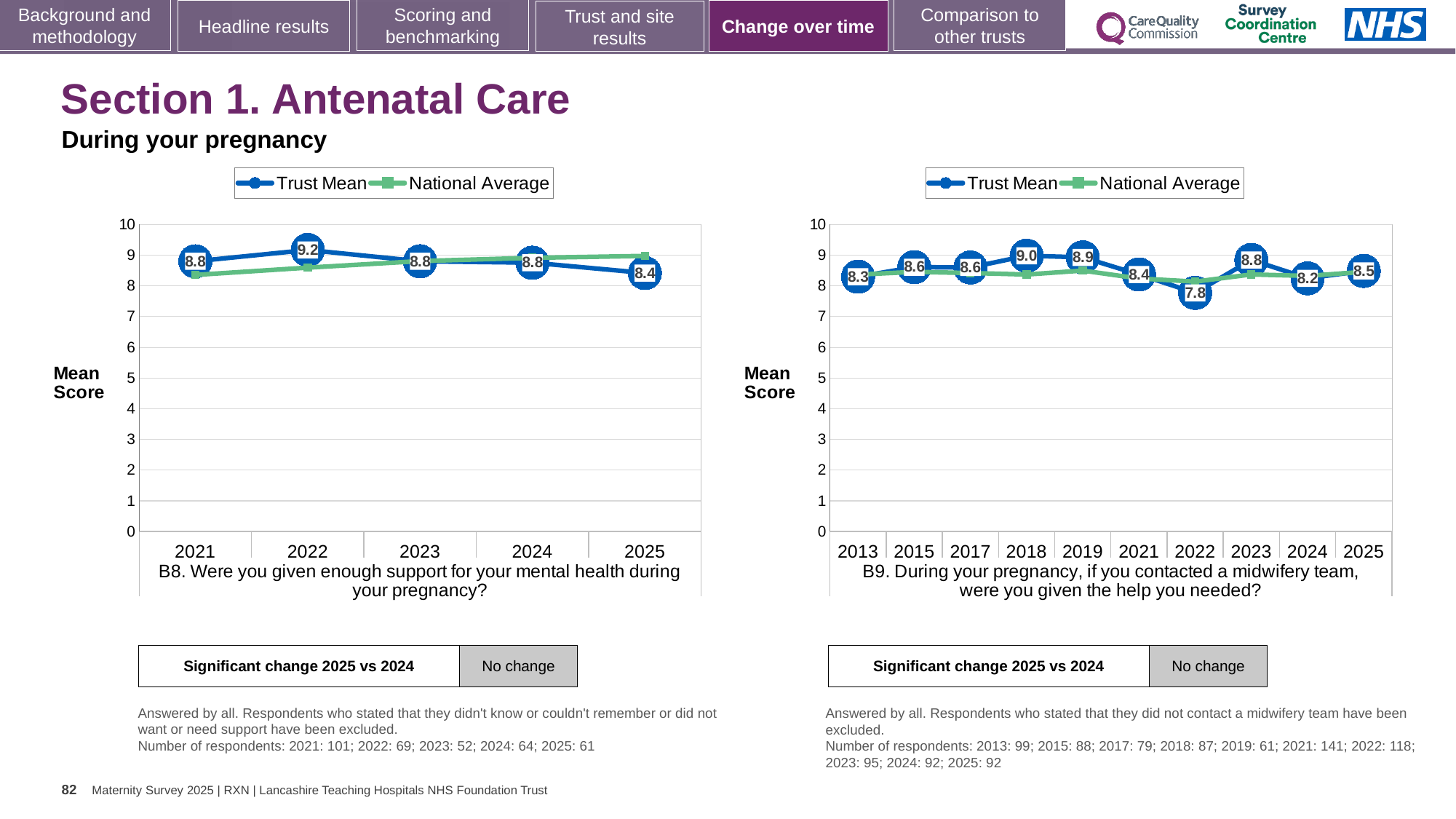
How many series does the legend of the B9 chart (right) list? 2 What kind of chart is the B8 chart (left)? Line chart In the B8 chart (left), what is the difference between the Trust Mean for 2022 and 2025? 0.8 In the B9 chart (right), which year has the highest Trust Mean? 2018 In the B8 chart (left), what is the Trust Mean for 2022? 9.2 In the B9 chart (right), what is the Trust Mean for 2022? 7.8 In the B8 chart (left), what is the Trust Mean for 2025? 8.4 In the B9 chart (right), which year has the lowest Trust Mean? 2022 In the B8 chart (left), which year has the highest Trust Mean? 2022 In the B9 chart (right), is the Trust Mean for 2019 larger or smaller than the Trust Mean for 2024? larger In the B8 chart (left), how many years are shown on the x axis? 5 In the B9 chart (right), how many years are shown on the x axis? 10